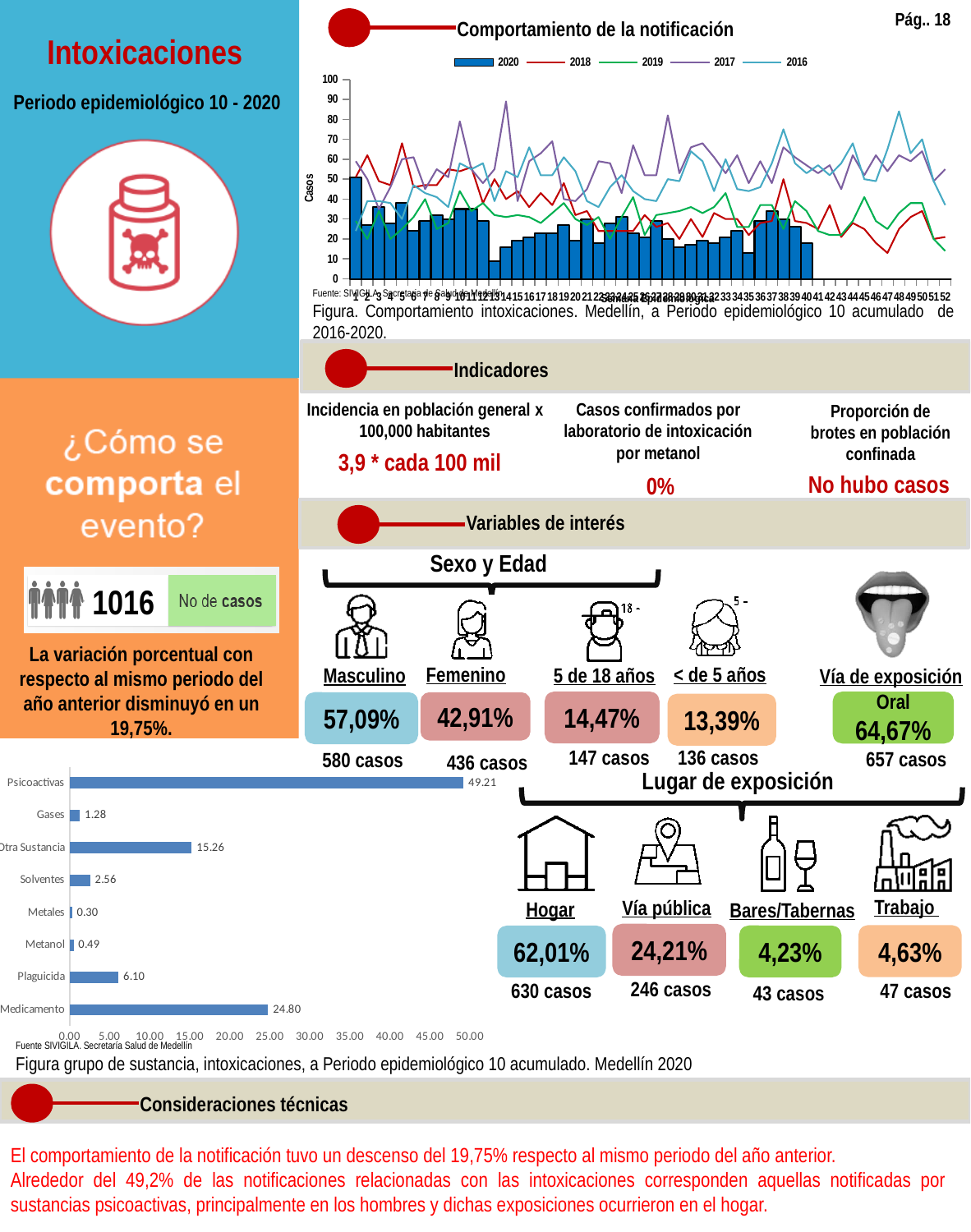
In the substance group bar chart at the bottom left, how many substance categories are shown? 8 In the 'Comportamiento de la notificación' chart at the top, what is the highest value shown on the y axis? 100 In the substance group bar chart at the bottom left, what is the value for Plaguicida? 6.10 In the substance group bar chart at the bottom left, what is the difference between the values for Psicoactivas and Medicamento? 24.41 In the substance group bar chart at the bottom left, what is the value for Psicoactivas? 49.21 In the substance group bar chart at the bottom left, which is larger, the value for Otra Sustancia or the value for Plaguicida? Otra Sustancia In the 'Comportamiento de la notificación' chart at the top, how many series does the legend list? 5 In the substance group bar chart at the bottom left, which category has the lowest value? Metales In the 'Comportamiento de la notificación' chart at the top, which series is drawn as bars rather than a line? 2020 In the substance group bar chart at the bottom left, what is the value for Medicamento? 24.80 In the substance group bar chart at the bottom left, which category has the highest value? Psicoactivas What kind of chart is the substance group chart at the bottom left of the slide? Bar chart